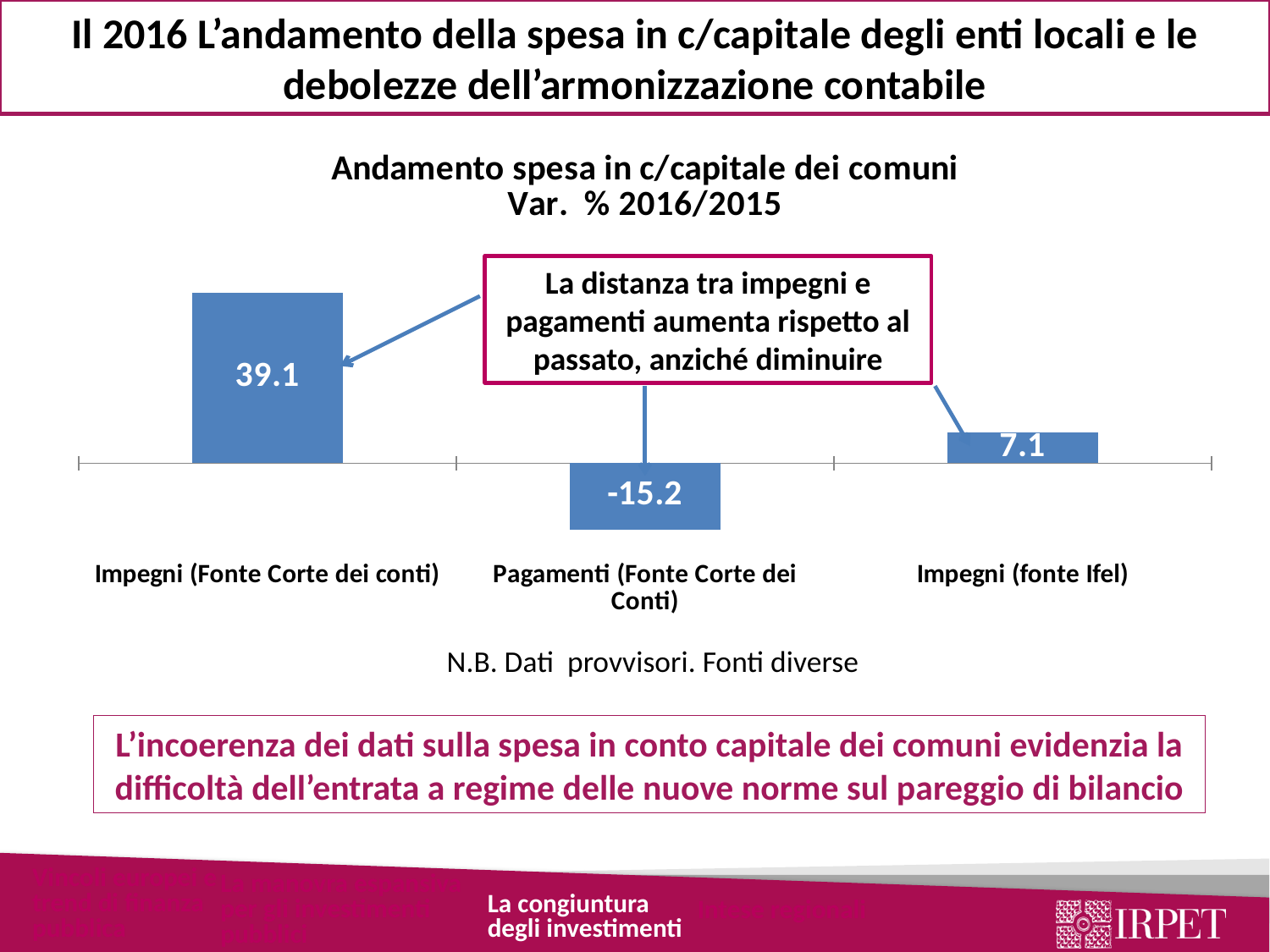
What is the value for Impegni (fonte Ifel)? 7.1 What kind of chart is shown on the slide? Bar chart How many categories have a negative value? 1 What is the difference between the values for Impegni (Fonte Corte dei conti) and Pagamenti (Fonte Corte dei Conti)? 54.3 How many categories are shown in the chart? 3 Which category has the highest value? Impegni (Fonte Corte dei conti) What is the difference between the values for Impegni (Fonte Corte dei conti) and Impegni (fonte Ifel)? 32.0 What is the value for Impegni (Fonte Corte dei conti)? 39.1 What is the title of the chart? Andamento spesa in c/capitale dei comuni Var. % 2016/2015 What is the value for Pagamenti (Fonte Corte dei Conti)? -15.2 Which category has the lowest value? Pagamenti (Fonte Corte dei Conti) Which is larger, the value for Impegni (fonte Ifel) or the value for Pagamenti (Fonte Corte dei Conti)? Impegni (fonte Ifel)